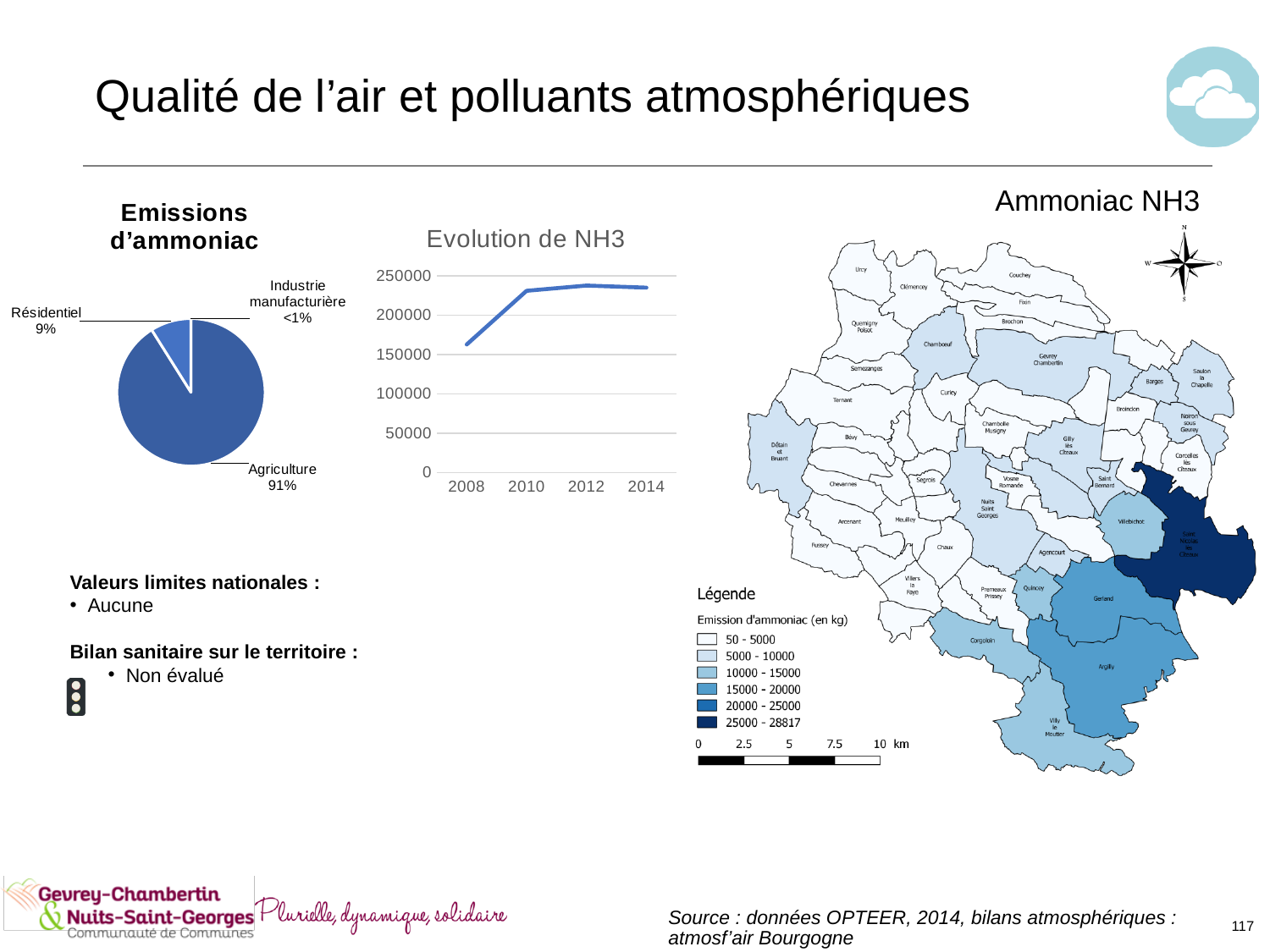
In the 'Evolution de NH3' chart, is the value for 2008 greater or less than 200000? less In the 'Emissions d'ammoniac' pie chart, what share of emissions comes from Agriculture? 91% In the 'Evolution de NH3' chart, which year has a larger value, 2008 or 2010? 2010 In the 'Emissions d'ammoniac' pie chart, how many sectors are shown? 3 In the 'Emissions d'ammoniac' pie chart, which sector has the largest share? Agriculture What kind of chart is 'Evolution de NH3'? Line chart In the 'Evolution de NH3' chart, how many years are plotted on the x axis? 4 In the 'Emissions d'ammoniac' pie chart, what share of emissions comes from Résidentiel? 9% In the 'Emissions d'ammoniac' pie chart, what is the difference in percentage points between Agriculture and Résidentiel? 82 In the 'Emissions d'ammoniac' pie chart, what share is shown for Industrie manufacturière? <1% In the 'Emissions d'ammoniac' pie chart, which sector has the smallest share? Industrie manufacturière In the 'Evolution de NH3' chart, is the value for 2012 greater or less than 200000? greater